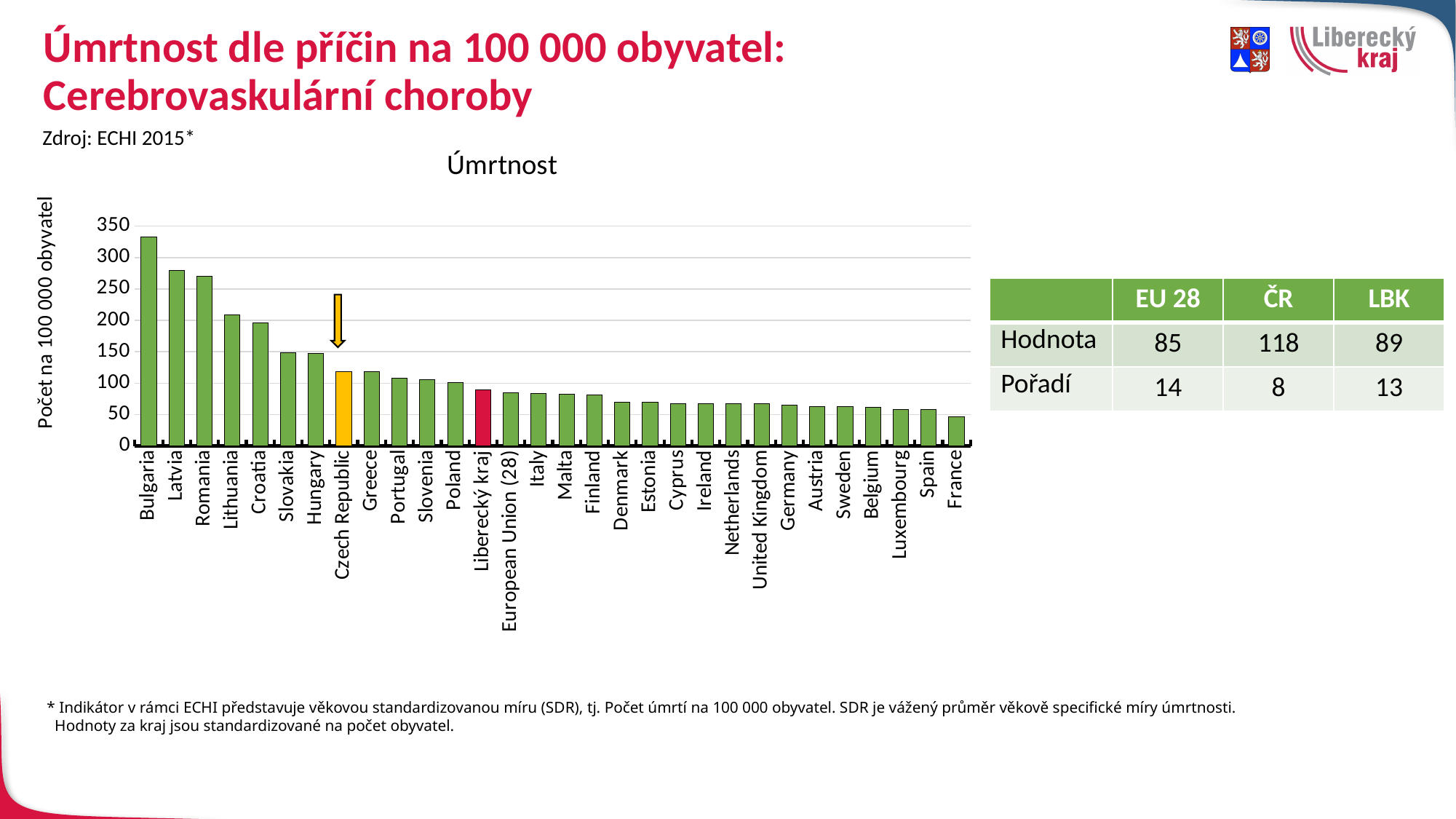
Is the value for Lithuania greater or less than 250? less What is the title of the chart? Úmrtnost Which country has the highest mortality value in the chart? Bulgaria How many categories (bars) are plotted in the chart? 30 Is the value for Bulgaria greater or less than 300? greater Is the value for Latvia greater or less than 250? greater Which country has the lowest mortality value in the chart? France Do the values rise or fall from left to right along the x axis? fall According to the table next to the chart, what is the value (Hodnota) for ČR? 118 What type of chart is shown on the slide? bar chart Which has a larger value, Romania or Croatia? Romania